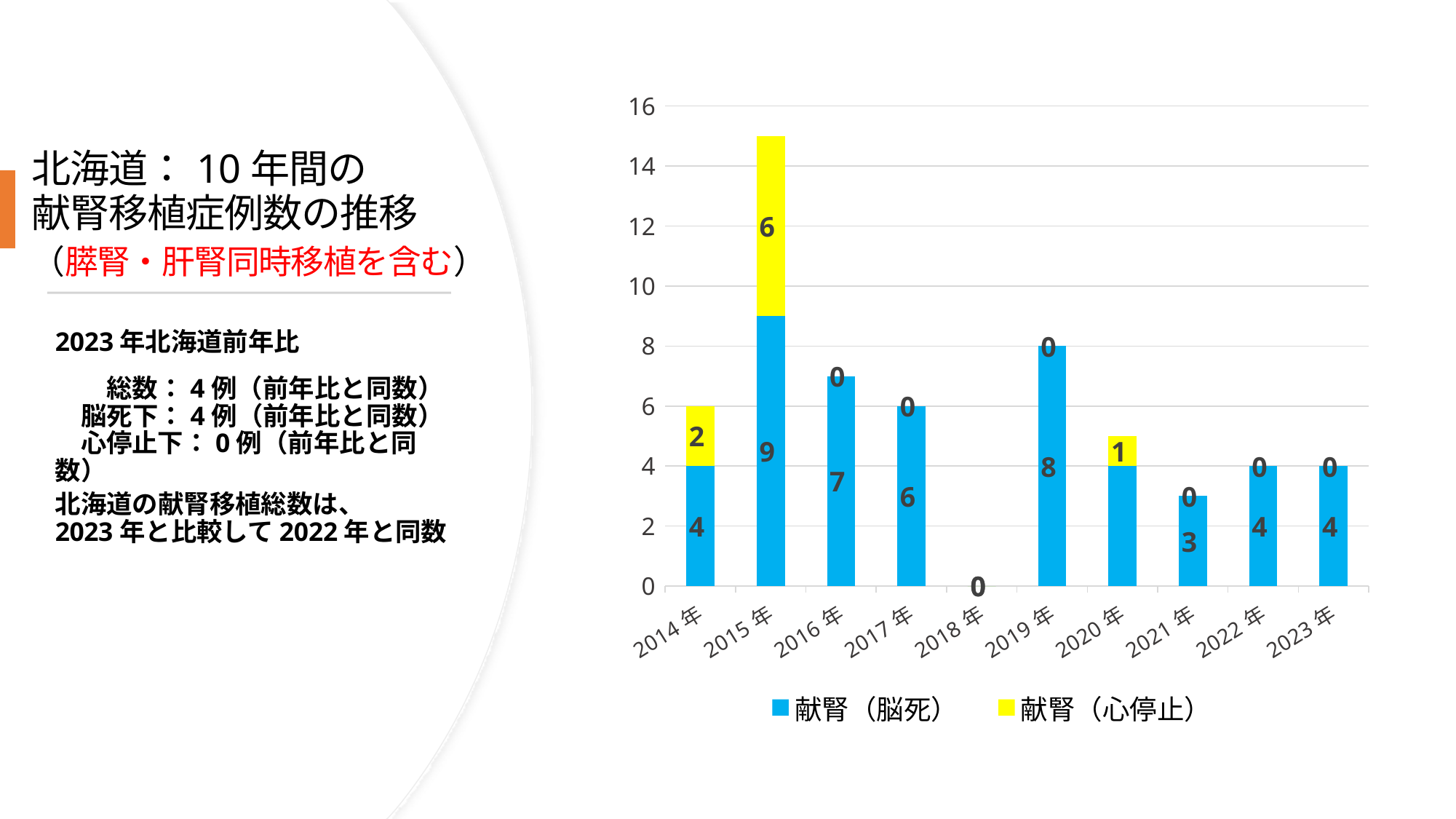
Which is larger, the 献腎（脳死） value for 2016年 or for 2022年? 2016年 What is the difference between the 献腎（脳死） values for 2019年 and 2017年? 2 How many years are shown on the x axis? 10 What is the value for 献腎（脳死） in 2021年? 3 What is the value for 献腎（心停止） in 2015年? 6 What is the total of the stacked bar for 2020年? 5 How many series does the legend list? 2 Which year has the highest value for 献腎（脳死）? 2015年 What kind of chart is shown on the slide? Stacked bar chart What is the value for 献腎（心停止） in 2014年? 2 What is the value for 献腎（脳死） in 2015年? 9 What is the total of the stacked bar for 2015年? 15